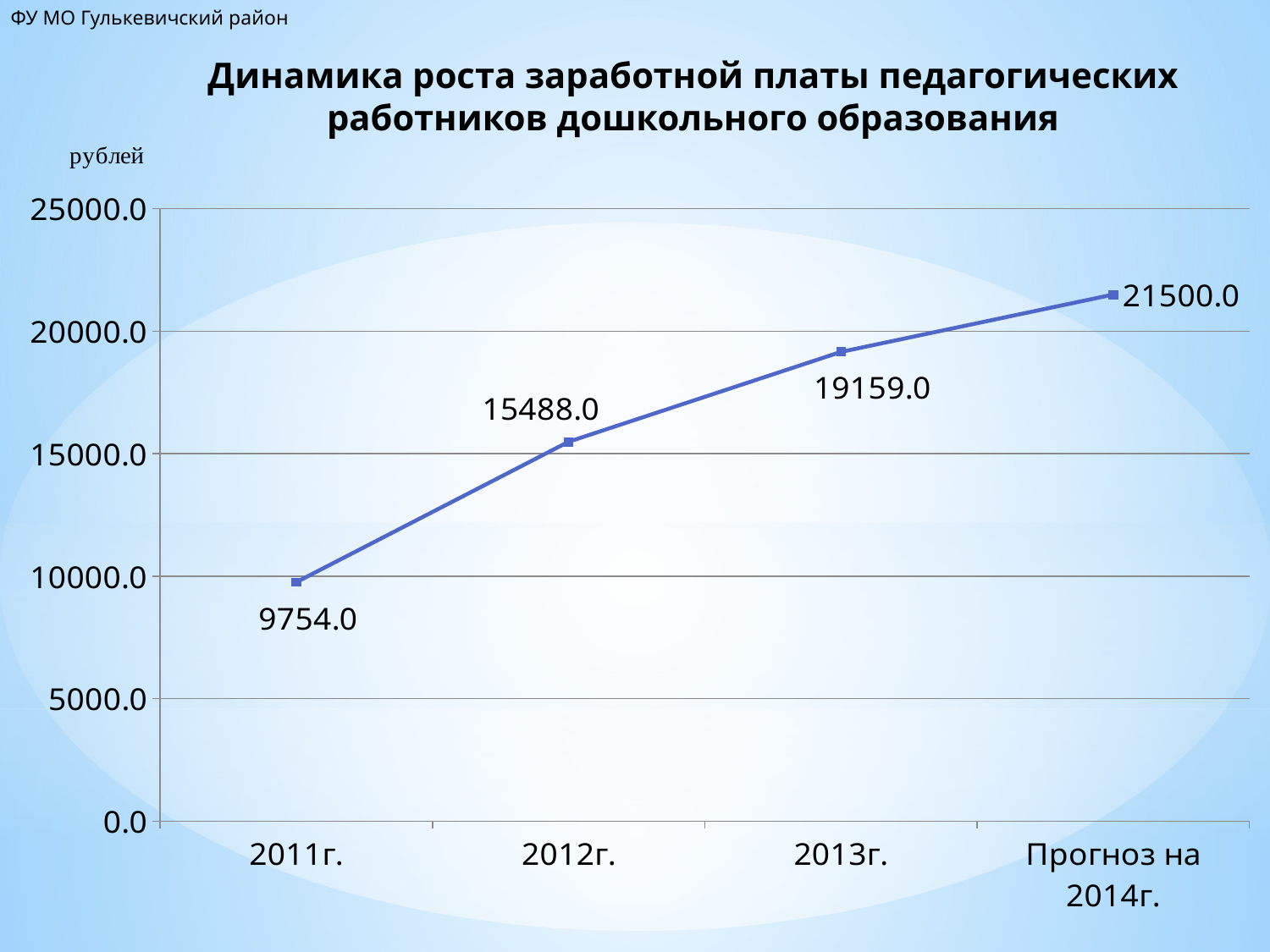
Which category has the lowest value? 2011г. How many data points are plotted on the chart? 4 What is the difference between the values for Прогноз на 2014г. and 2013г.? 2341.0 What is the value for Прогноз на 2014г.? 21500.0 Which category has the highest value? Прогноз на 2014г. Do the values rise or fall from 2011г. to Прогноз на 2014г.? rise What is the difference between the values for 2012г. and 2011г.? 5734.0 Which is larger, the value for 2013г. or the value for 2012г.? 2013г. What kind of chart is shown on the slide? line chart What is the value for 2012г.? 15488.0 What is the value for 2013г.? 19159.0 What is the value for 2011г.? 9754.0